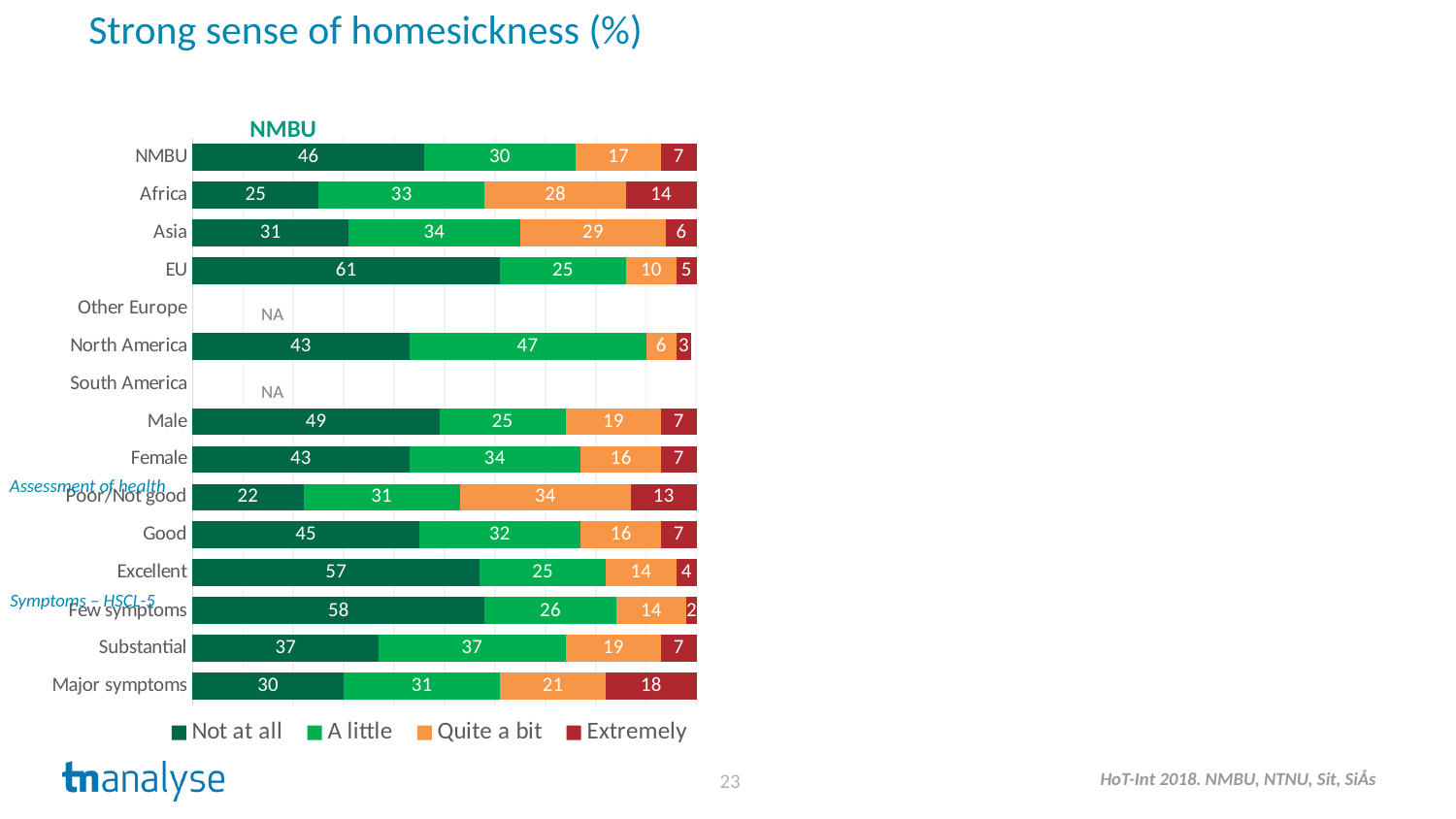
What is the 'Extremely' value for Major symptoms? 18 What is the 'Quite a bit' value for Asia? 29 What is the total of the stacked bar for Africa? 100 What is the 'Quite a bit' value for Poor/Not good? 34 Which is larger, the 'A little' value for North America or for Asia? North America Which category has the highest 'Not at all' value? EU Which two categories are shown as NA? Other Europe and South America Which category has the lowest 'Extremely' value? Few symptoms What is the 'Not at all' value for EU? 61 How many series does the legend list? 4 What is the difference between the 'Not at all' values for Male and Female? 6 What kind of chart is shown on the slide? Stacked bar chart